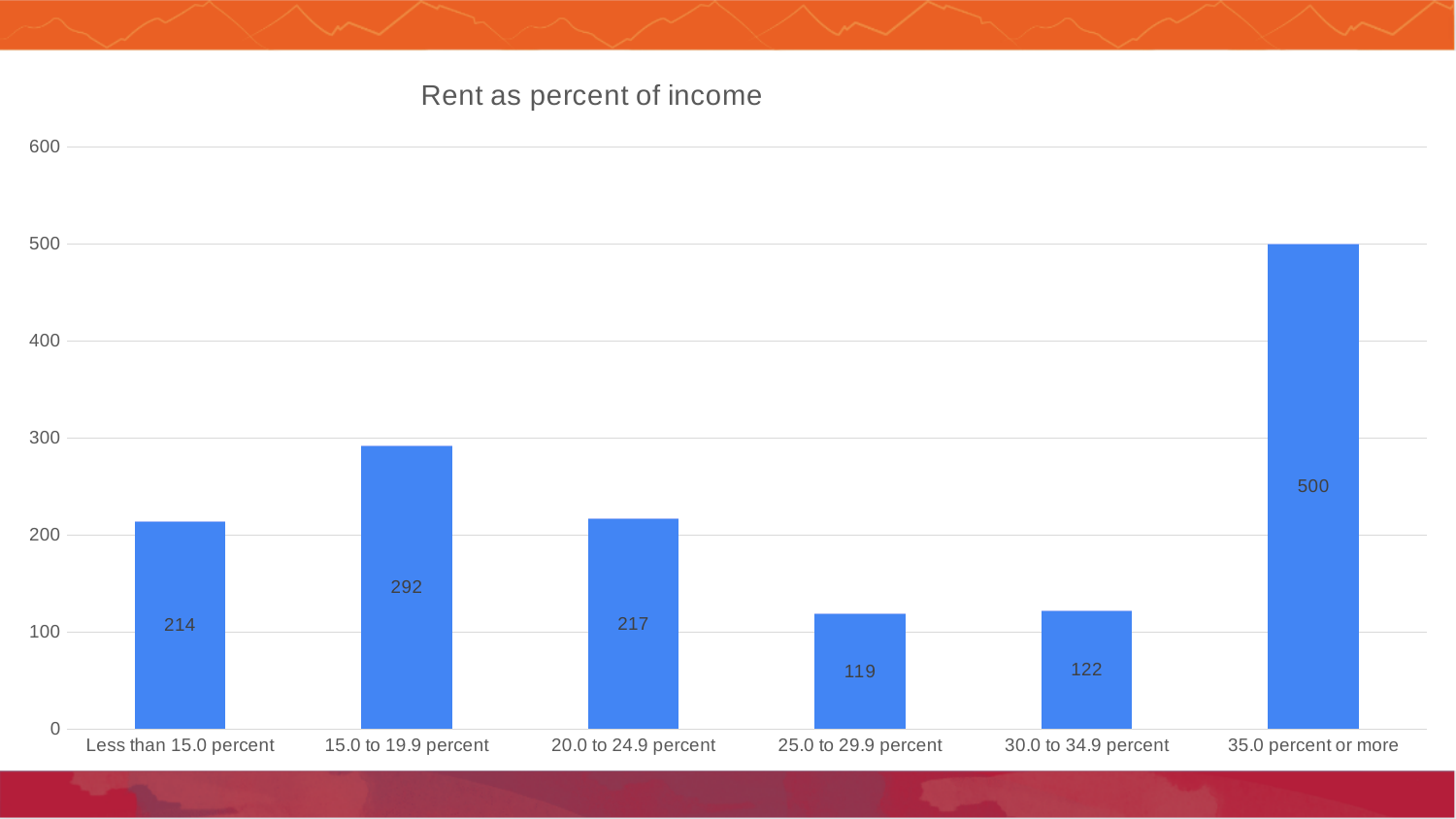
How many categories are shown on the x axis? 6 Which category has the lowest value? 25.0 to 29.9 percent What is the difference between the values for '35.0 percent or more' and '15.0 to 19.9 percent'? 208 Which category has the highest value? 35.0 percent or more What is the value for the '15.0 to 19.9 percent' category? 292 What is the value for the '25.0 to 29.9 percent' category? 119 What is the value for the '35.0 percent or more' category? 500 What is the title of the chart? Rent as percent of income What kind of chart is shown on the slide? bar chart Which is larger, the value for '15.0 to 19.9 percent' or the value for '20.0 to 24.9 percent'? 15.0 to 19.9 percent What is the difference between the values for '20.0 to 24.9 percent' and 'Less than 15.0 percent'? 3 Is the value for '30.0 to 34.9 percent' greater or less than 200? less